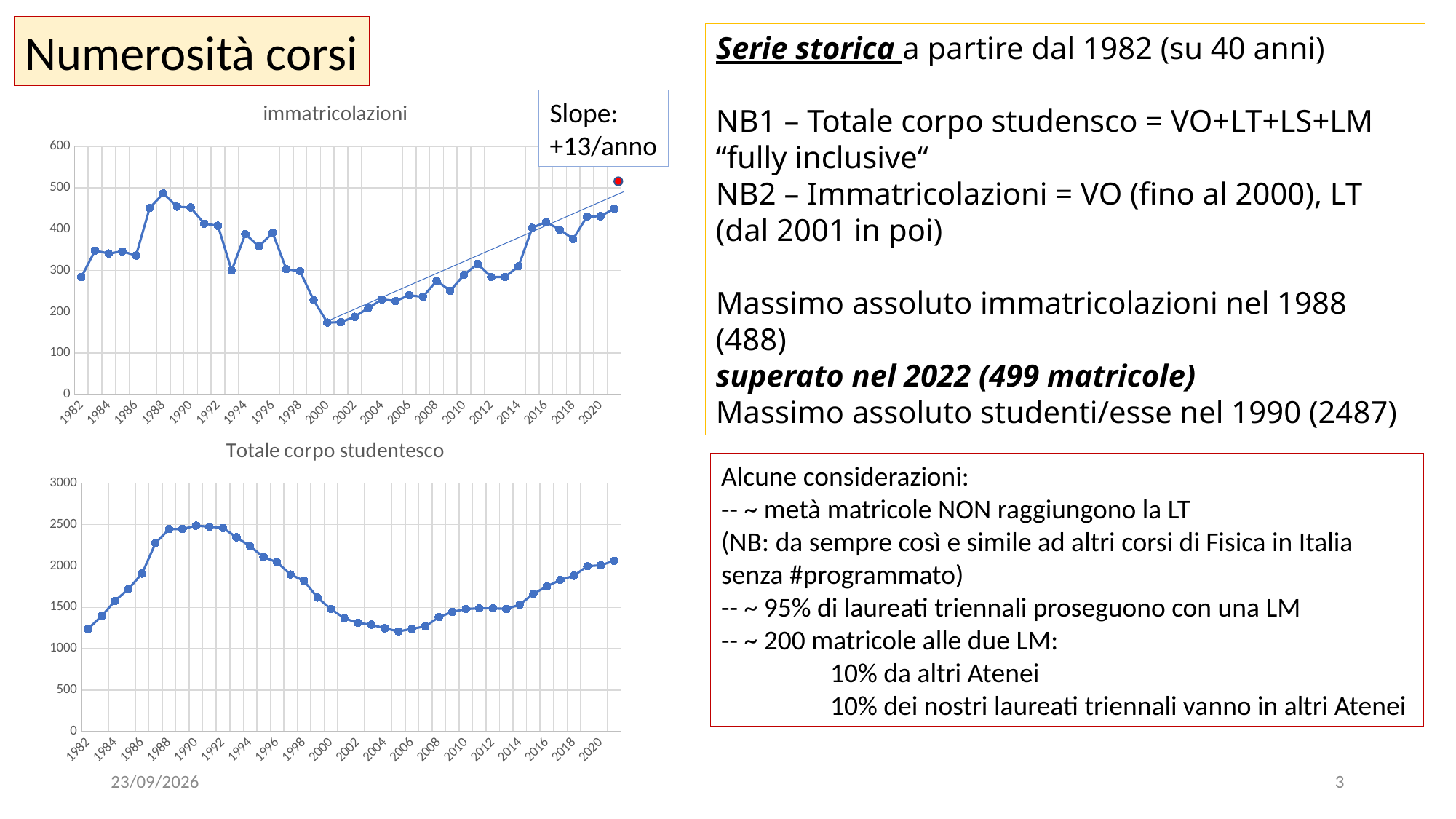
How many charts are shown on the slide? 2 In the 'Totale corpo studentesco' chart, is the value for 2006 greater or less than 1500? less In the 'Totale corpo studentesco' chart, do the values rise or fall from 1992 to 2006? fall In the 'Totale corpo studentesco' chart, is the value for 1990 greater or less than 2000? greater In the 'immatricolazioni' chart, which year has the larger value, 1982 or 1988? 1988 What kind of chart is the 'Totale corpo studentesco' chart? line chart In the 'immatricolazioni' chart, is the value for 2000 greater or less than 200? less What kind of chart is the 'immatricolazioni' chart? line chart In the 'Totale corpo studentesco' chart, which year has the larger value, 1990 or 2006? 1990 What slope is annotated on the 'immatricolazioni' chart? +13/anno